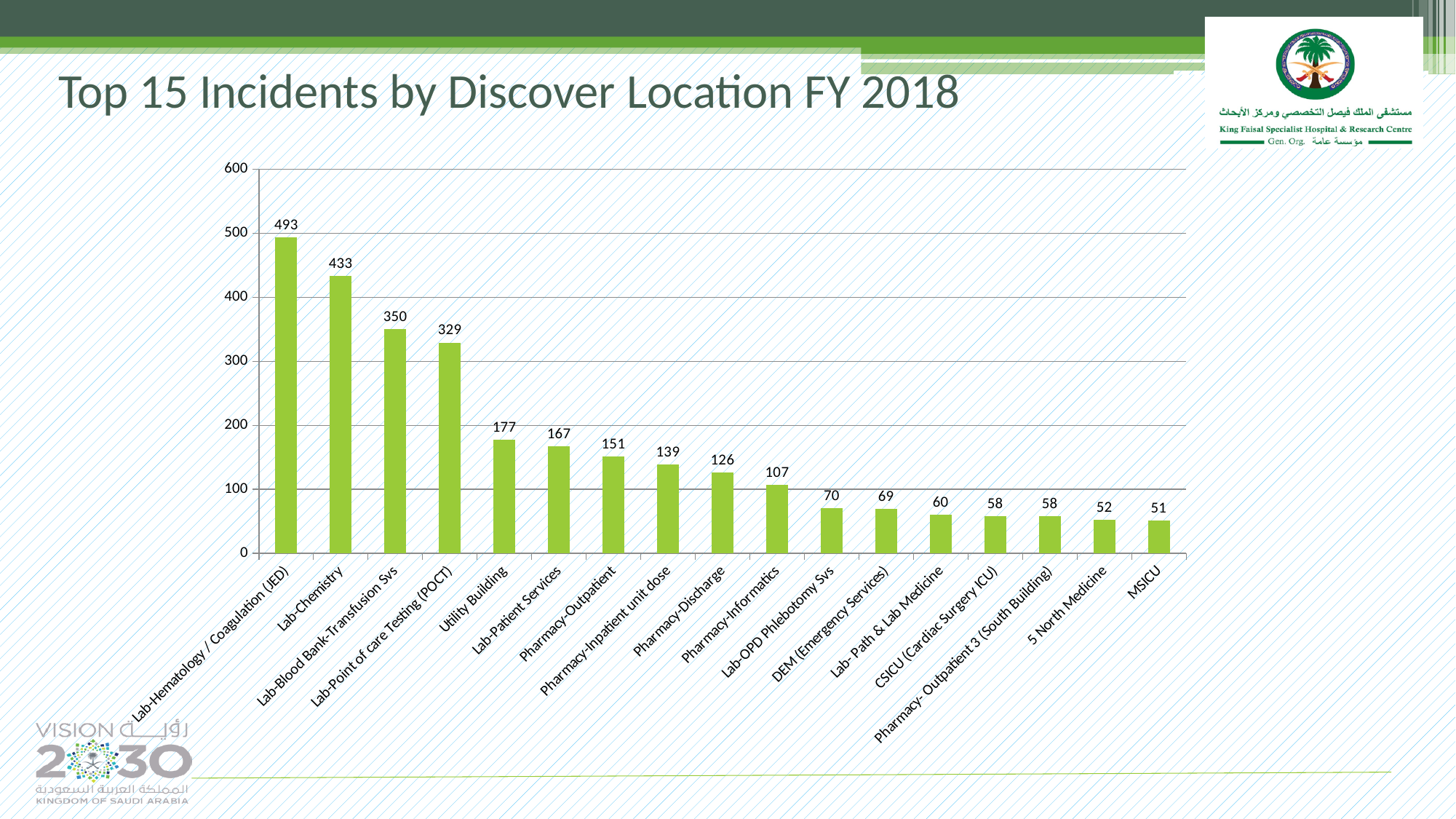
How many incidents were recorded for Lab-Chemistry? 433 Which has more incidents, Lab-Blood Bank-Transfusion Svs or Lab-Point of care Testing (POCT)? Lab-Blood Bank-Transfusion Svs What is the difference between the values for Lab-Hematology / Coagulation (JED) and Lab-Chemistry? 60 Which location has the highest number of incidents? Lab-Hematology / Coagulation (JED) What is the value shown for DEM (Emergency Services)? 69 What is the difference between the values for Utility Building and Lab-Patient Services? 10 How many locations are shown on the chart? 17 What is the value shown for Pharmacy-Inpatient unit dose? 139 Do the values rise or fall from left to right along the x axis? Fall What type of chart is shown on the slide? Bar chart Which location has the lowest number of incidents? MSICU Is the value for Pharmacy-Discharge greater or less than 100? greater